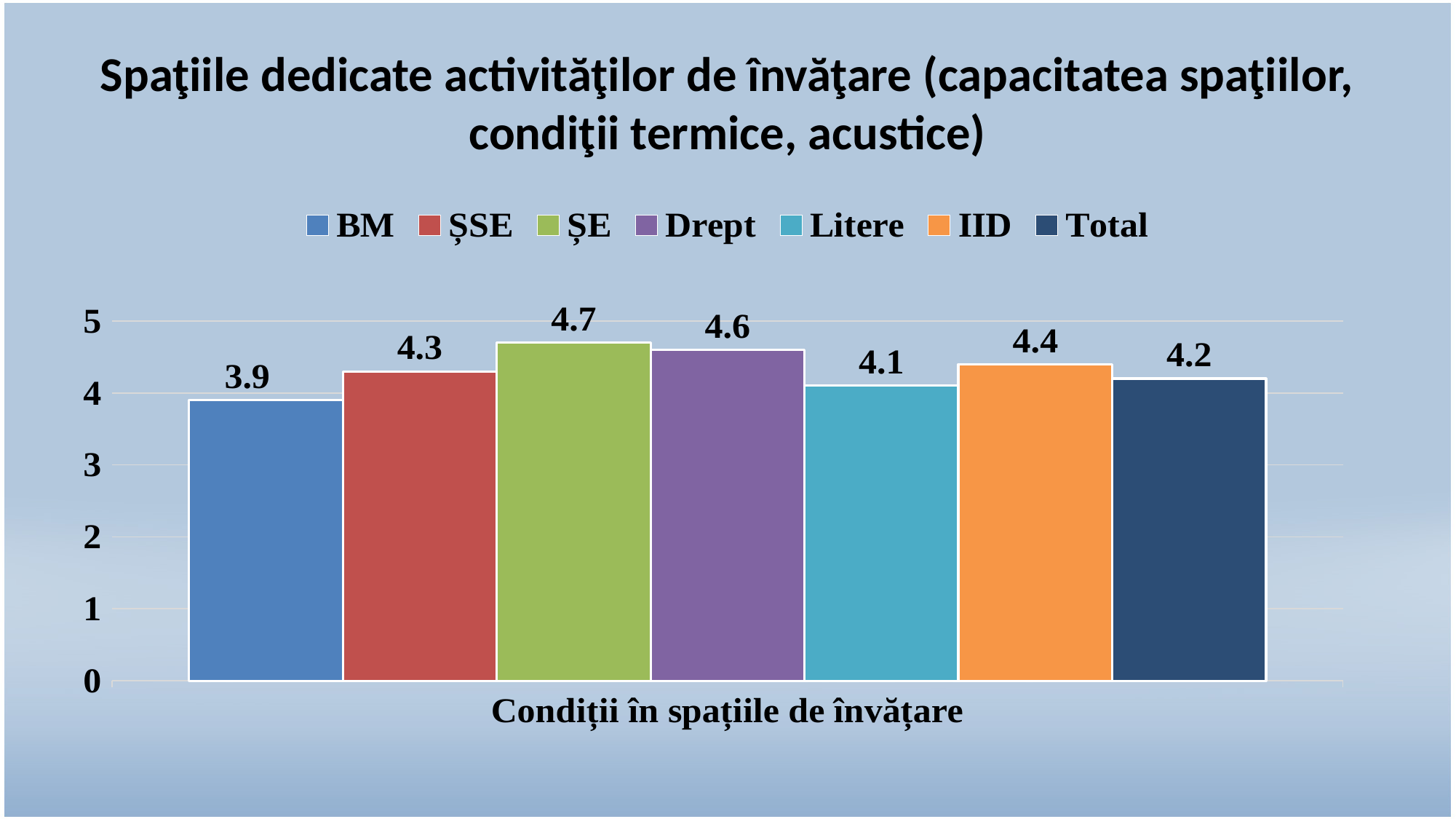
Which is larger, the value for Drept or the value for ȘSE? Drept What is the value for BM? 3.9 What is the difference between the values for IID and Litere? 0.3 What is the value for Litere? 4.1 What is the value for Total? 4.2 How many series does the legend list? 7 Which series has the highest value? ȘE What is the label on the x axis of the chart? Condiții în spațiile de învățare What is the value for ȘE? 4.7 Which series has the lowest value? BM What kind of chart is shown on the slide? Bar chart What is the difference between the values for ȘE and BM? 0.8